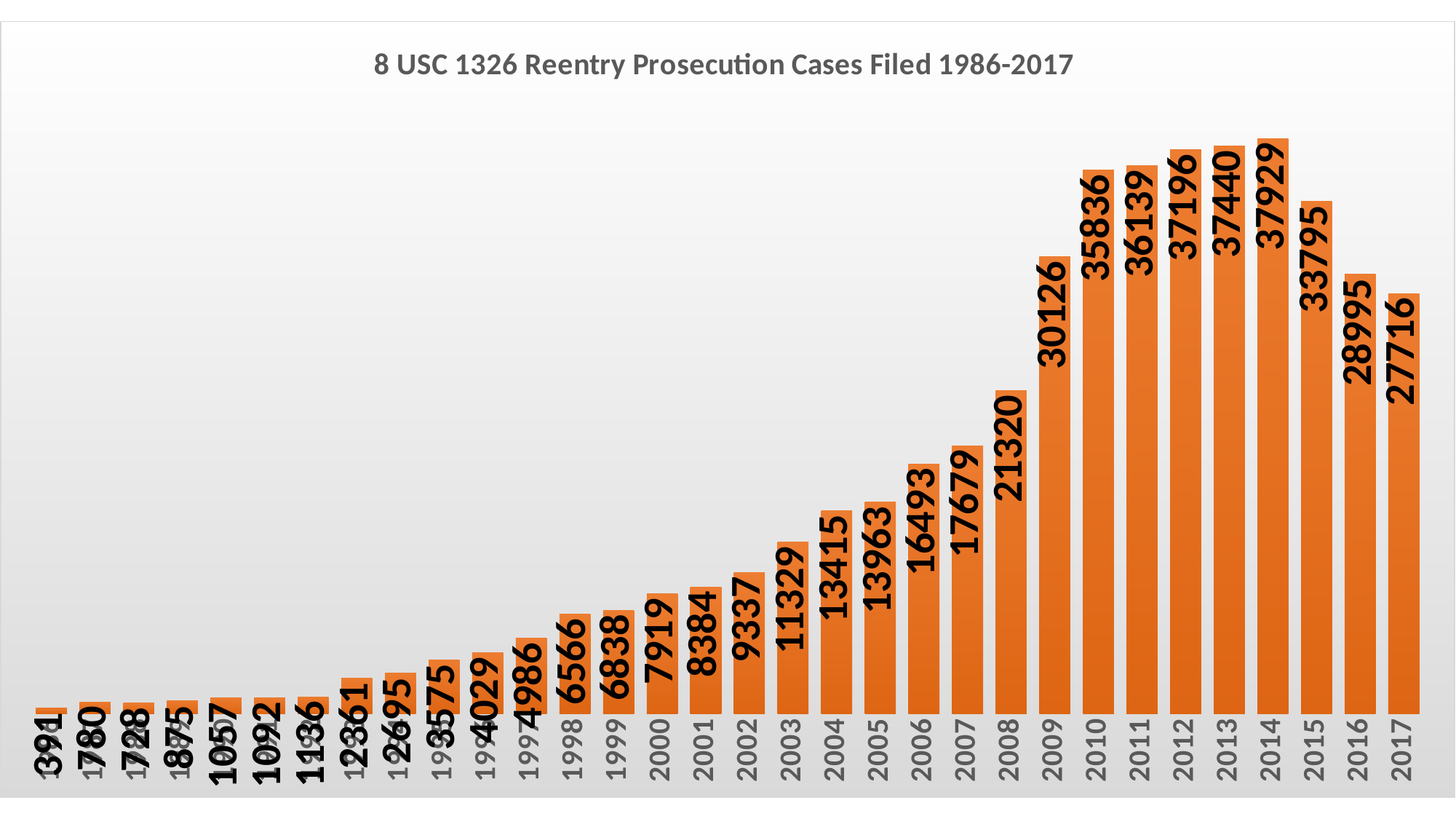
By how much did the number of cases increase from 2008 to 2009? 8806 What is the difference between the values for 2014 and 2015? 4134 What kind of chart is shown on the slide? Bar chart Which year has the larger value, 2010 or 2011? 2011 How many reentry prosecution cases were filed in 2009? 30126 Which year has the highest number of cases filed? 2014 What is the value shown for 2008? 21320 What is the title of the chart? 8 USC 1326 Reentry Prosecution Cases Filed 1986-2017 How many years (bars) are shown in the chart? 32 What is the value shown for 2017? 27716 What is the value shown for 2003? 11329 Do the values rise or fall from 2014 to 2017? Fall